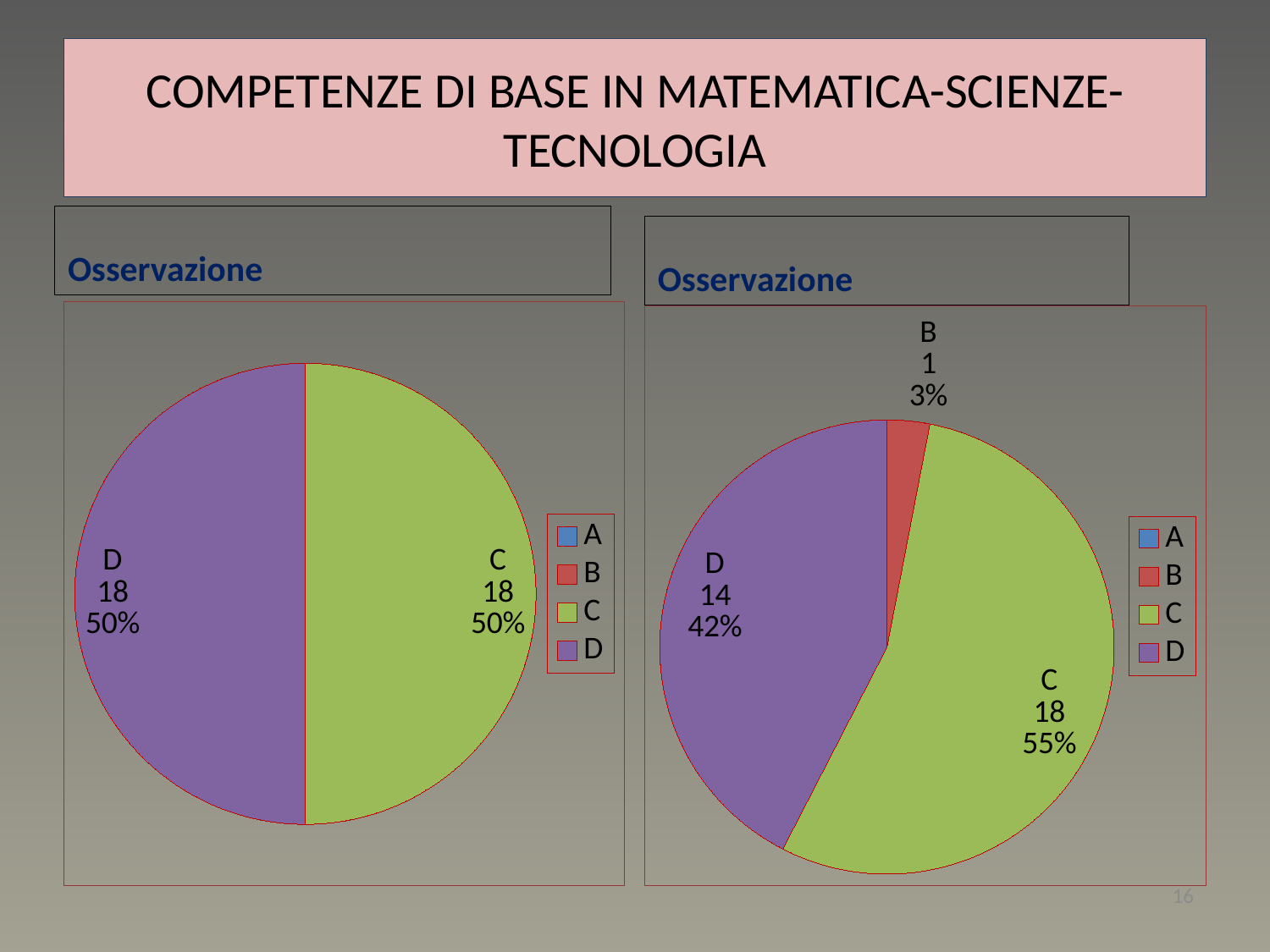
In the left pie chart, what percentage is shown for slice C? 50% In the right pie chart, what is the difference between the values for C and D? 4 In the right pie chart, what value is shown for slice B? 1 How many entries does the legend of the left pie chart list? 4 In the right pie chart, which is larger, the value for D or the value for B? D In the left pie chart, what value is shown for slice D? 18 What is the title shown above the right pie chart? Osservazione In the right pie chart, which slice is the largest? C In the right pie chart, which slice is the smallest? B In the right pie chart, what percentage is shown for slice D? 42% How many slices with data labels does the right pie chart have? 3 What type of chart is shown on the left of the slide? pie chart